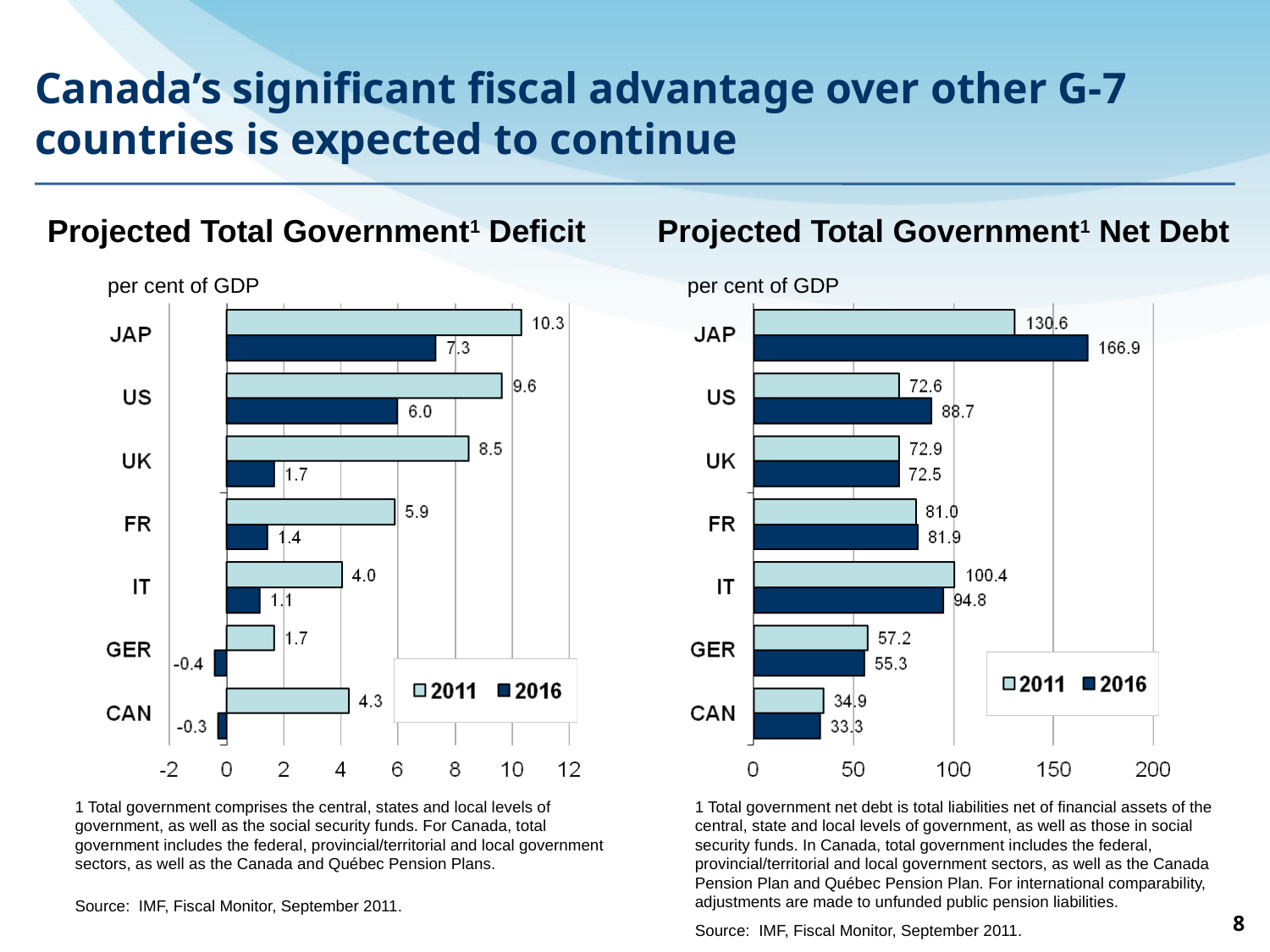
In the Projected Total Government Net Debt chart, what is the difference between the 2016 and 2011 values for US? 16.1 In the Projected Total Government Deficit chart, what is the 2016 value for CAN? -0.3 In the Projected Total Government Net Debt chart, which is larger for IT: the 2011 value or the 2016 value? 2011 In the Projected Total Government Deficit chart, which country has the highest 2016 value? JAP How many countries are shown in the Projected Total Government Deficit chart? 7 In the Projected Total Government Deficit chart, what is the 2011 value for JAP? 10.3 In the Projected Total Government Deficit chart, what is the difference between the 2011 and 2016 values for US? 3.6 What type of chart is the Projected Total Government Deficit chart? Bar chart In the Projected Total Government Net Debt chart, what is the 2011 value for CAN? 34.9 In the Projected Total Government Net Debt chart, which country has the lowest 2011 value? CAN How many series does the legend list in the Projected Total Government Net Debt chart? 2 In the Projected Total Government Net Debt chart, what is the 2016 value for JAP? 166.9